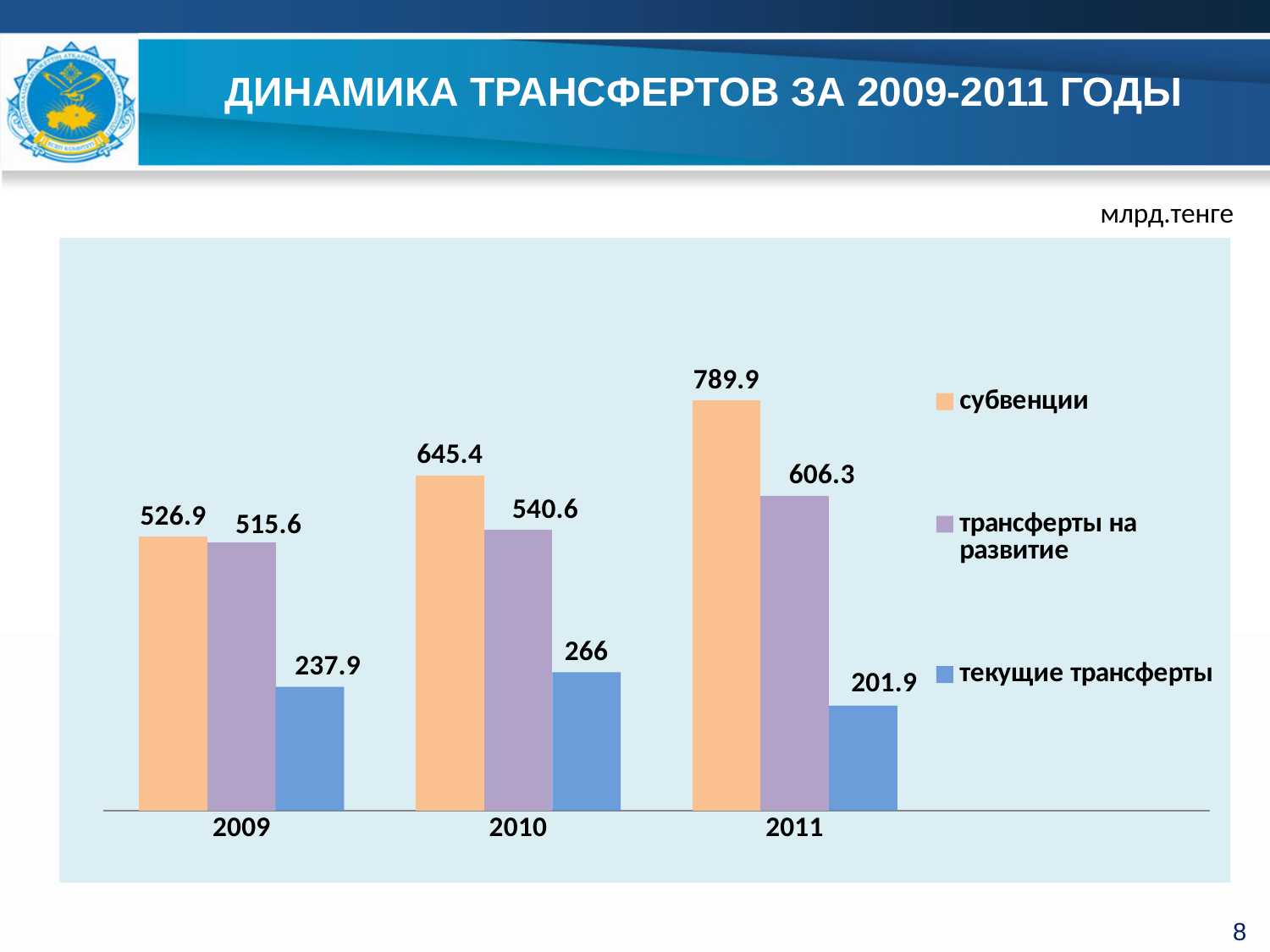
In which year is the value for субвенции highest? 2011 How many series does the legend list? 3 What kind of chart is shown on the slide? bar chart Which is larger in 2010: субвенции or текущие трансферты? субвенции What is the value for субвенции in 2011? 789.9 How many years are shown on the x axis? 3 What is the value for трансферты на развитие in 2010? 540.6 What is the value for текущие трансферты in 2009? 237.9 What is the difference between субвенции and трансферты на развитие in 2011? 183.6 In which year is the value for текущие трансферты lowest? 2011 Do the values for субвенции rise or fall from 2009 to 2011? rise What unit is indicated above the chart? млрд.тенге